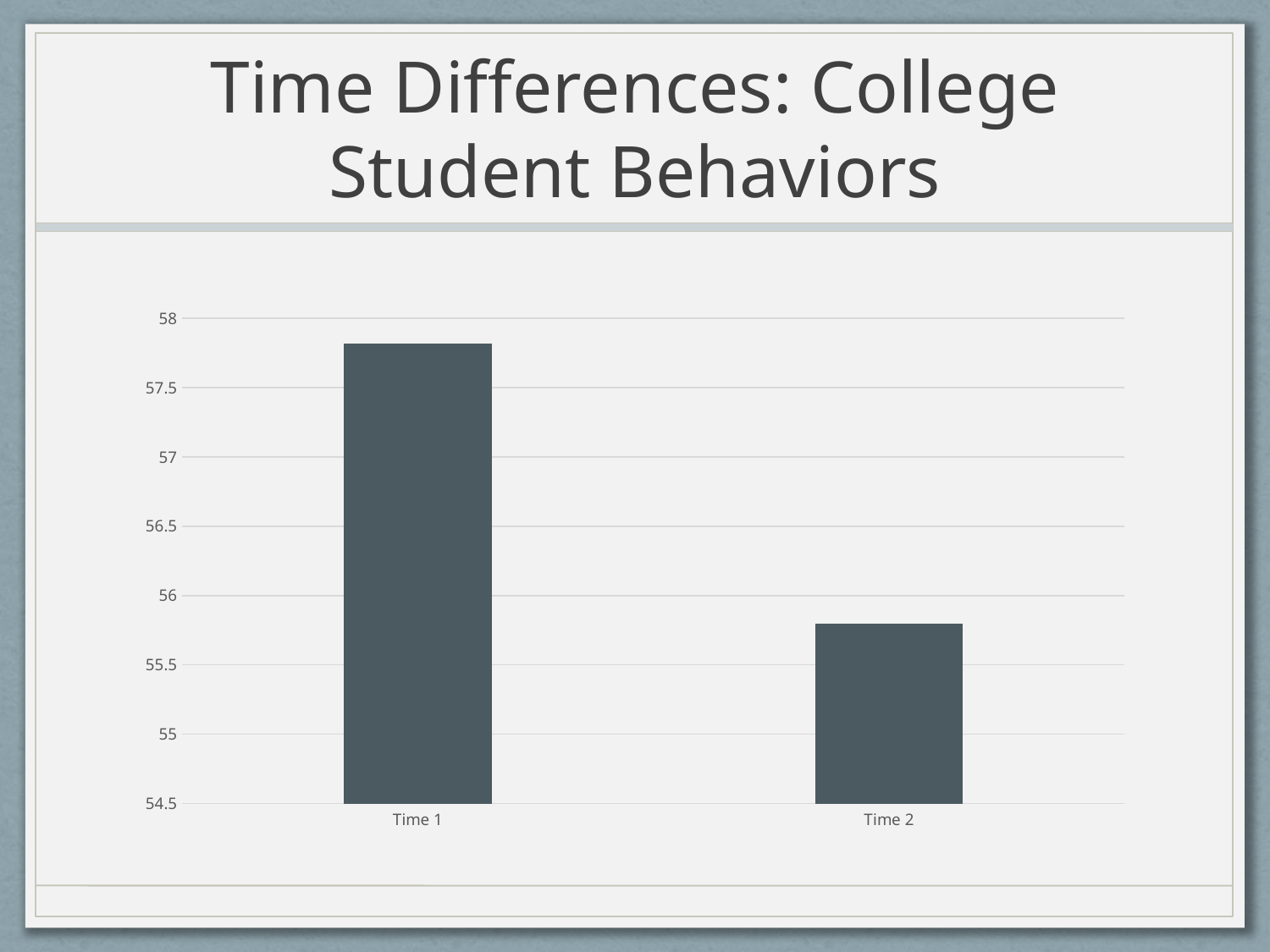
Which is larger, the value for Time 1 or the value for Time 2? Time 1 Is the value for Time 1 greater or less than 58? less What is the lowest value shown on the y axis? 54.5 Is the value for Time 2 greater or less than 55.5? greater How many categories are plotted on the x axis? 2 Is the value for Time 1 greater or less than 57.5? greater What kind of chart is shown on the slide? bar chart Which category has the highest value? Time 1 Which category has the lowest value? Time 2 What is the title of the slide containing the chart? Time Differences: College Student Behaviors Do the values rise or fall from Time 1 to Time 2? fall